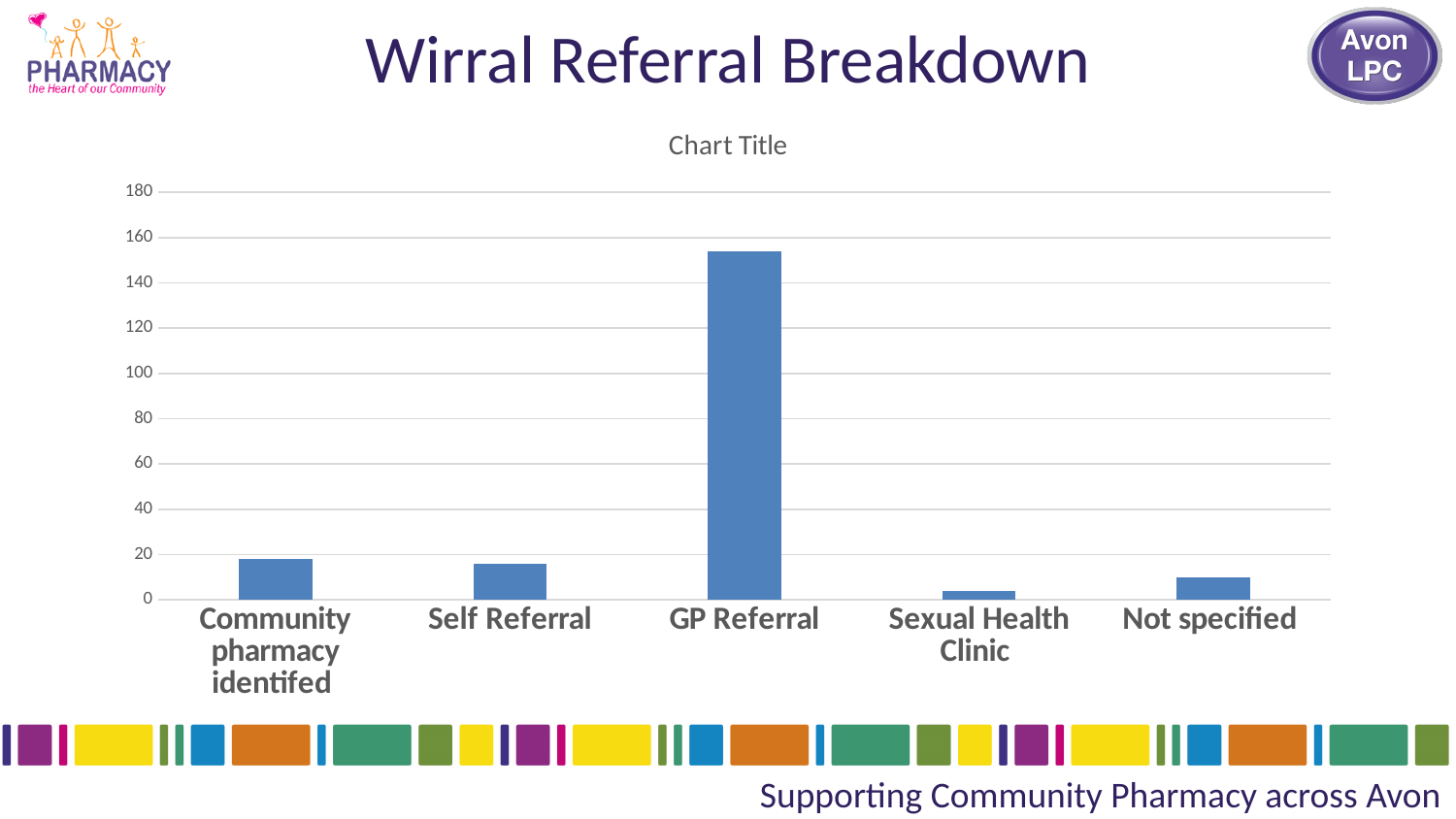
Is the value for GP Referral greater or less than 140? greater How many categories are shown on the x axis of the chart? 5 Is the value for Community pharmacy identifed greater or less than 40? less Which is larger, the value for Not specified or the value for Sexual Health Clinic? Not specified What kind of chart is shown on the slide? bar chart Which category has the lowest value in the chart? Sexual Health Clinic Which is larger, the value for GP Referral or the value for Self Referral? GP Referral What title is printed directly above the chart's plot area? Chart Title Is the value for Not specified greater or less than 20? less Which category has the highest value in the chart? GP Referral